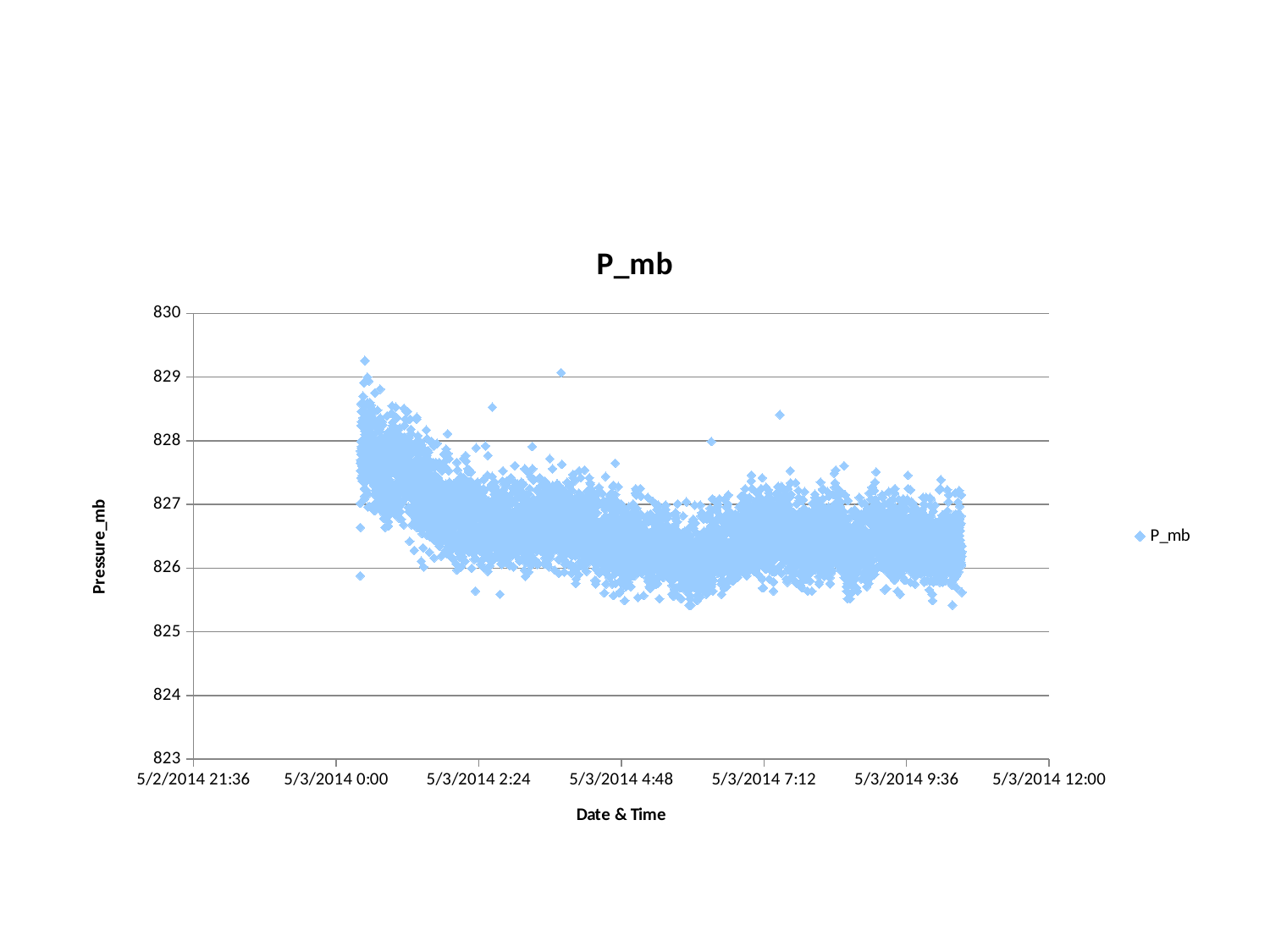
Is the lowest plotted value greater or less than 826? less Are the values plotted near 5/3/2014 7:12 greater or less than 828? less What is the title of the chart? P_mb What is the label on the vertical axis? Pressure_mb Is the highest plotted value greater or less than 828? greater Do the plotted pressure values generally rise or fall as time moves along the x axis? fall How many series does the legend list? 1 What kind of chart is shown on the slide? scatter chart